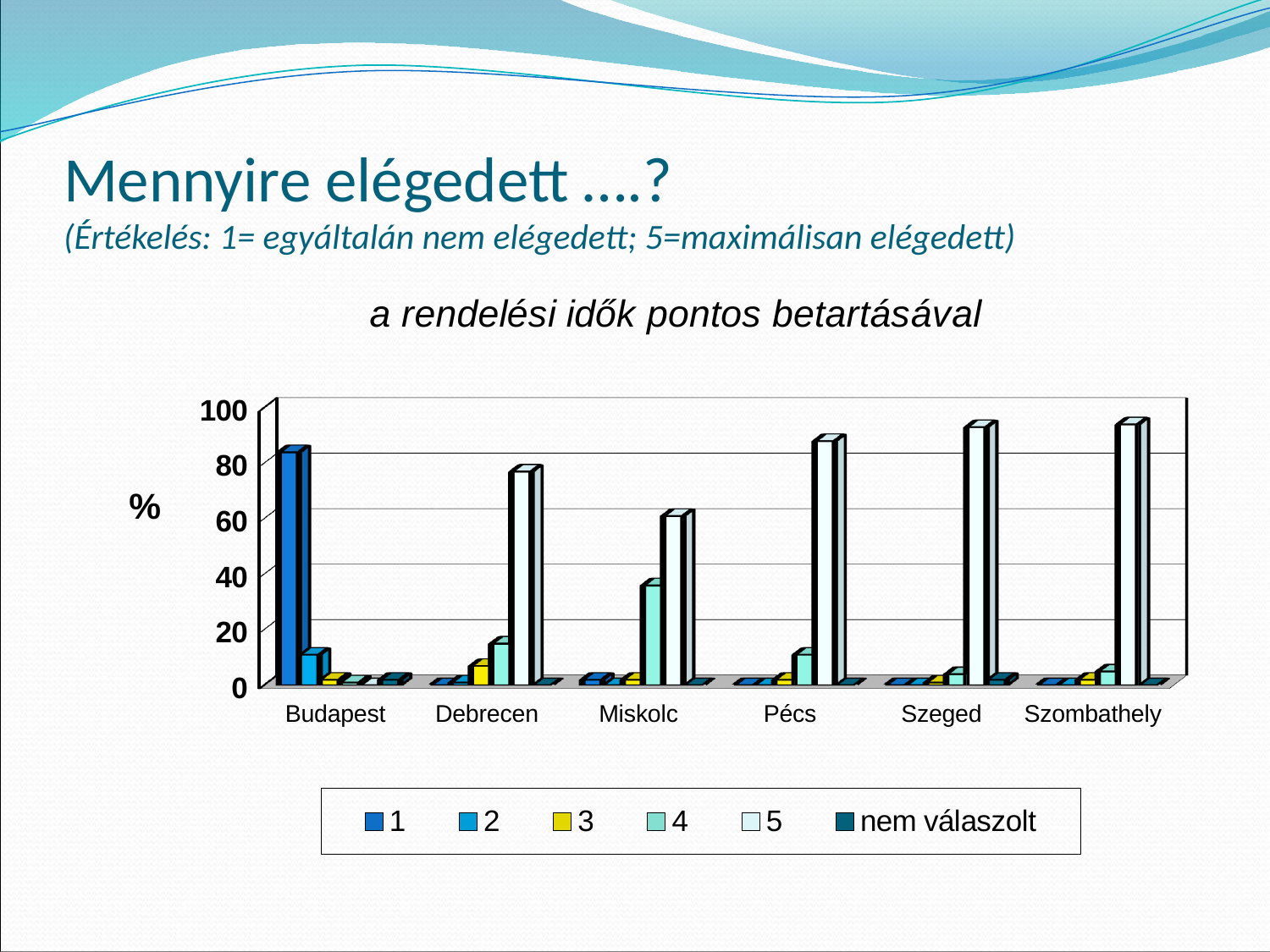
Which series has the tallest bar for Budapest? 1 Is the value for series 4 in Miskolc greater or less than 20? greater Is the value for series 5 in Pécs greater or less than 80? greater How many series does the chart's legend list? 6 Which series has the tallest bar for Debrecen? 5 For Miskolc, which is larger: the bar for series 4 or the bar for series 5? series 5 Which city has the tallest bar for series 1? Budapest Is the value for series 1 in Budapest greater or less than 60? greater How many cities are shown on the x axis of the chart? 6 What is the label on the chart's vertical axis? % What kind of chart is shown on the slide? bar chart